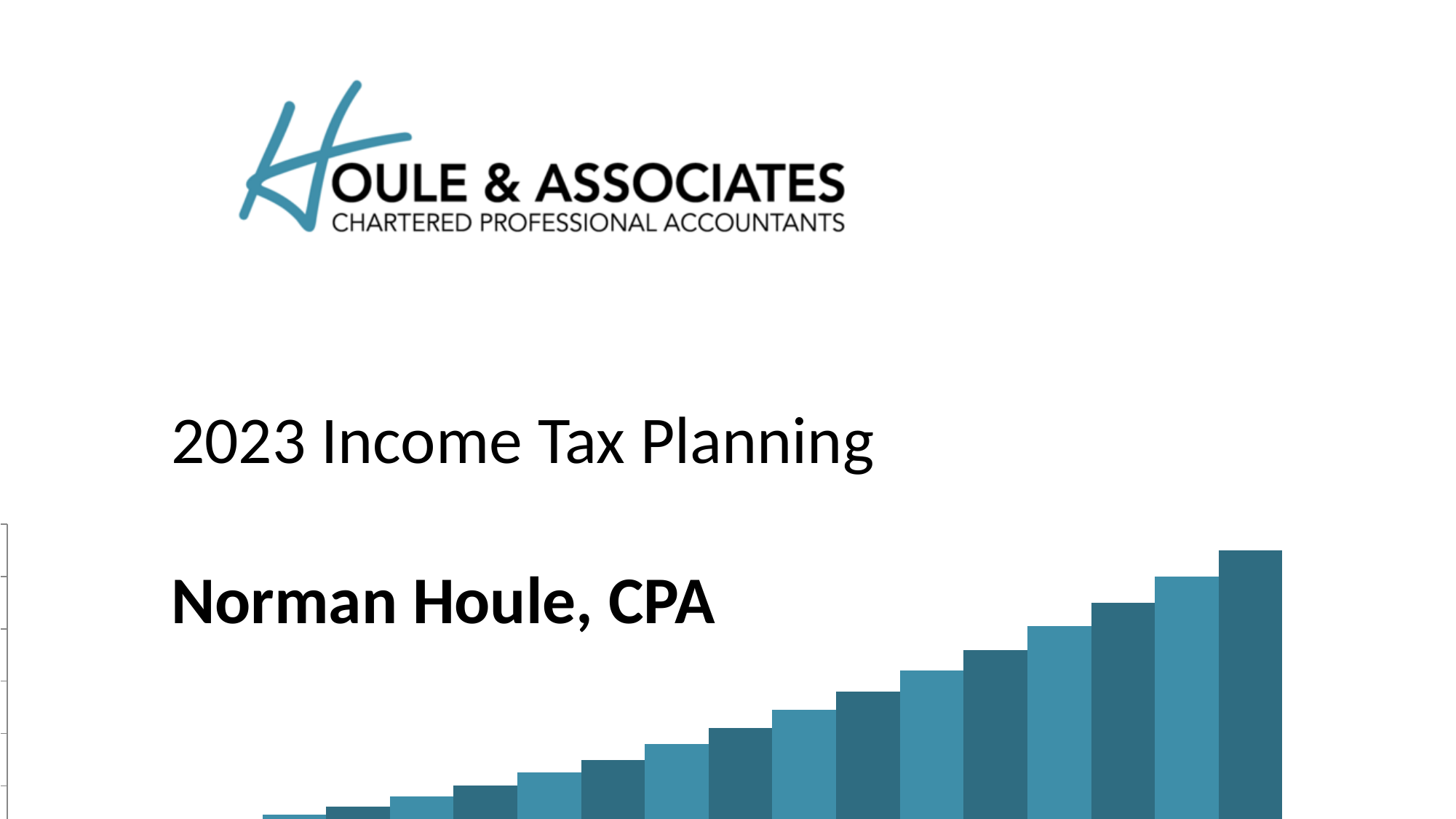
In the chart at the bottom of the slide, is the shortest bar on the left side or the right side? left side How many different shades are used for the bars in the chart at the bottom of the slide? 2 Do the bar heights in the chart at the bottom of the slide rise or fall from left to right? rise In the chart at the bottom of the slide, is the tallest bar on the left side or the right side? right side Does the chart at the bottom of the slide show any data labels or axis values? No What kind of chart is shown at the bottom of the slide? bar chart